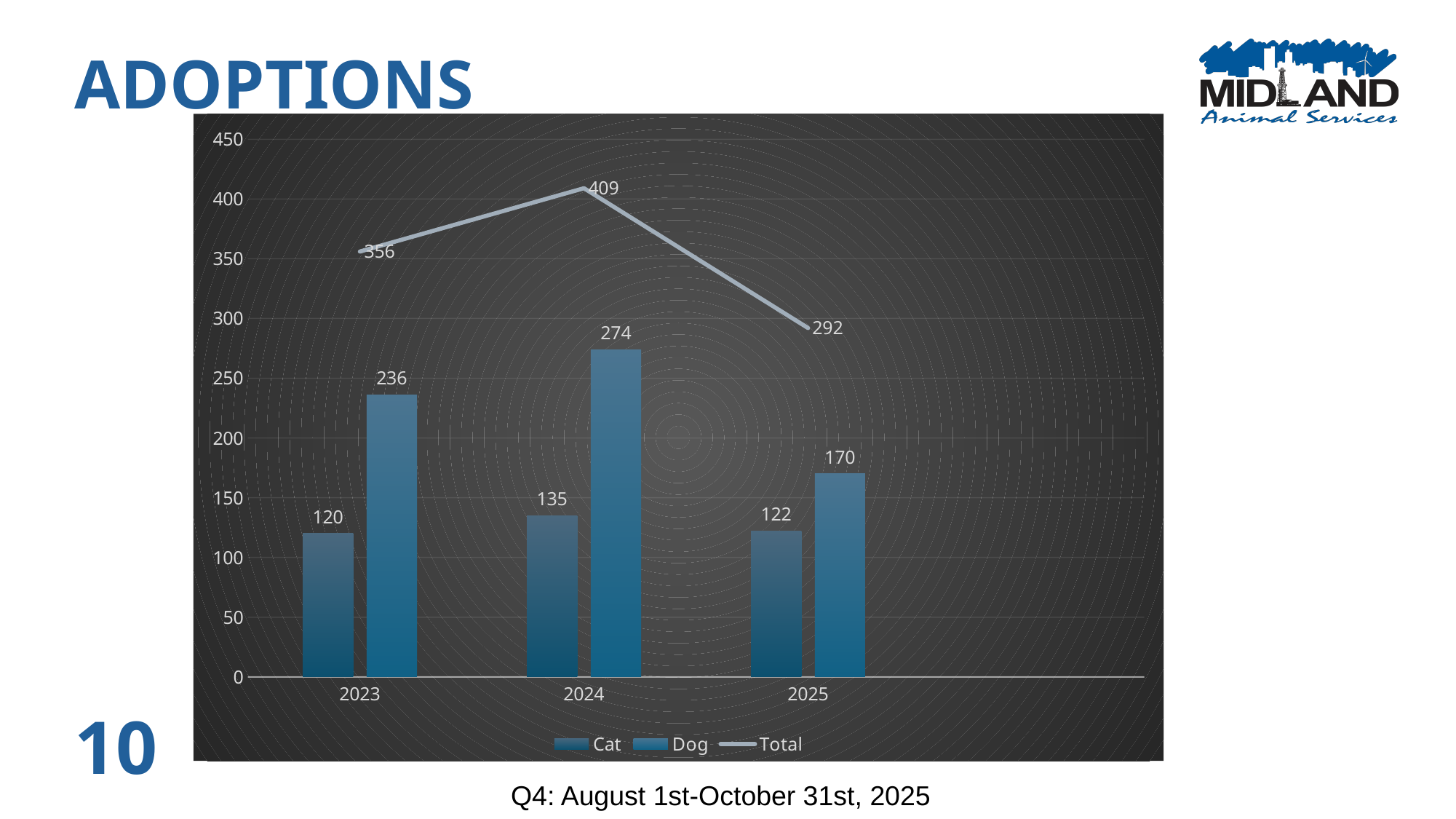
What is the Total value for 2025? 292 Which is larger, the Cat value in 2024 or the Cat value in 2025? Cat in 2024 How many series does the legend list? 3 What kind of chart is this? Combined bar and line chart How many years are shown on the x axis? 3 What is the value for Cat in 2023? 120 What is the difference between the Dog and Cat values in 2023? 116 What is the value for Dog in 2024? 274 What is the title of the slide? ADOPTIONS Does the Total line rise or fall from 2024 to 2025? Fall Which year has the lowest Dog value? 2025 Which year has the highest Total? 2024